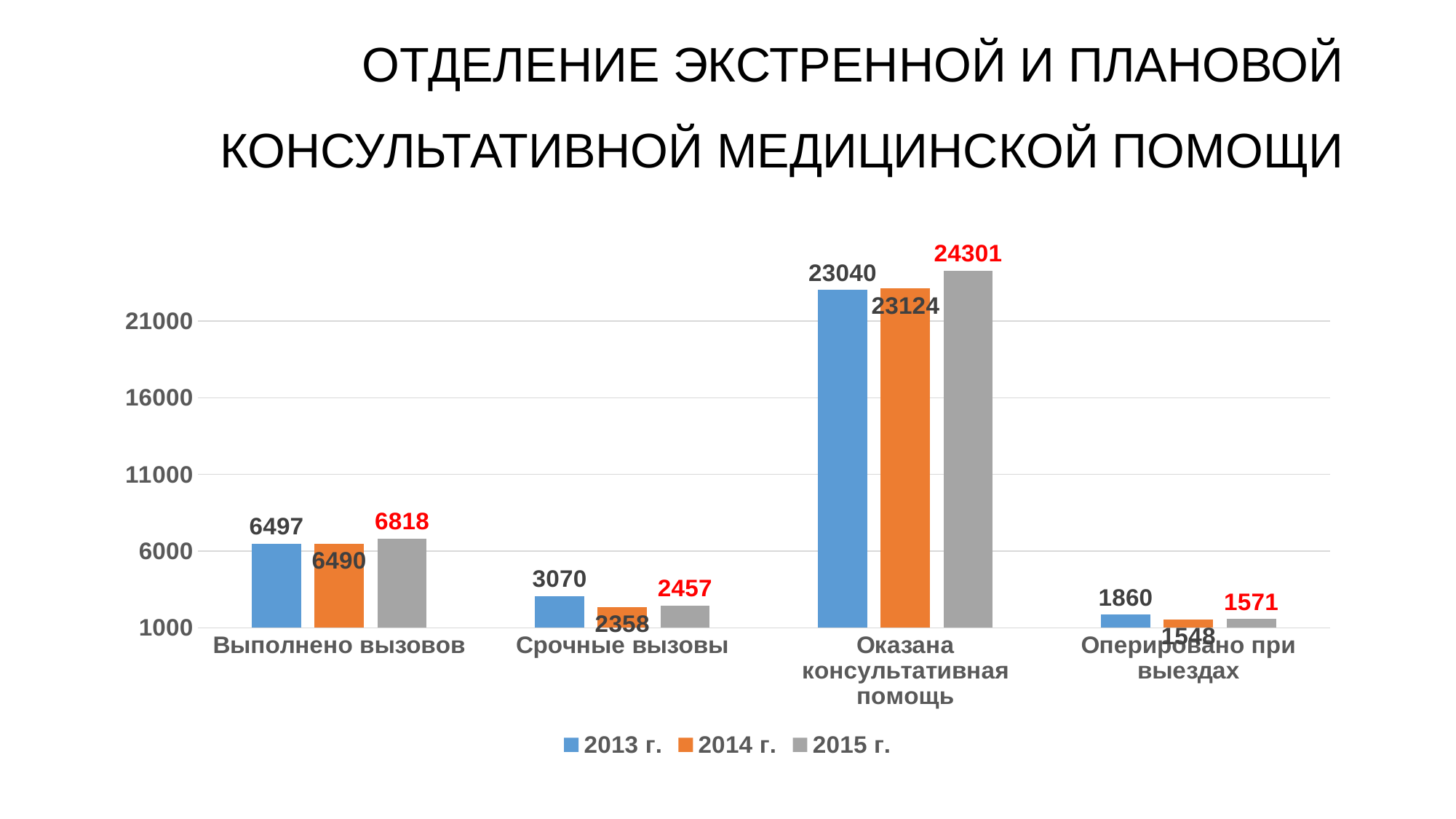
What kind of chart is shown on the slide? bar chart What is the value for 2015 г. in the category Выполнено вызовов? 6818 What is the value for 2013 г. in the category Срочные вызовы? 3070 What is the value for 2014 г. in the category Оказана консультативная помощь? 23124 How many categories are shown on the x axis? 4 Which category has the highest value for 2015 г.? Оказана консультативная помощь Is the 2015 г. value for Выполнено вызовов greater or less than 6000? greater Which category has the lowest value for 2013 г.? Оперировано при выездах What is the value for 2014 г. in the category Оперировано при выездах? 1548 How many series does the legend list? 3 What is the difference between the 2015 г. and 2013 г. values for Оказана консультативная помощь? 1261 Which is larger for Срочные вызовы: the 2013 г. value or the 2015 г. value? 2013 г.